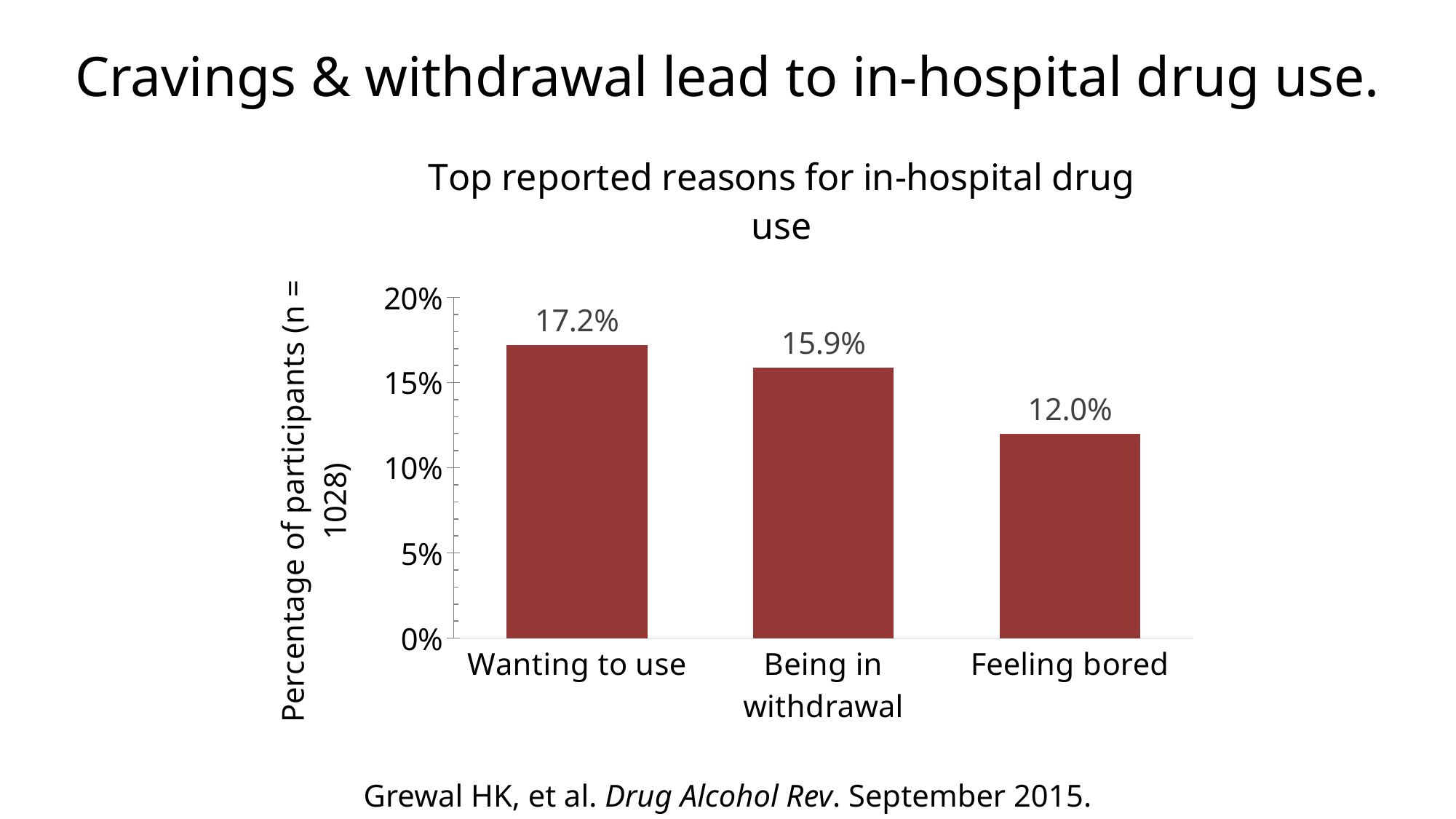
Which is larger: the percentage for "Being in withdrawal" or for "Feeling bored"? Being in withdrawal How many reasons are shown on the chart? 3 Is the value for "Being in withdrawal" greater or less than 15%? greater What percentage of participants reported "Wanting to use" as a reason for in-hospital drug use? 17.2% What percentage of participants reported "Being in withdrawal" as a reason for in-hospital drug use? 15.9% Which reason has the highest reported percentage? Wanting to use What is the difference in percentage points between "Wanting to use" and "Feeling bored"? 5.2% What is the title of the chart? Top reported reasons for in-hospital drug use Which reason has the lowest reported percentage? Feeling bored What percentage of participants reported "Feeling bored" as a reason for in-hospital drug use? 12.0% What is the difference in percentage points between "Wanting to use" and "Being in withdrawal"? 1.3% What kind of chart is shown on the slide? Bar chart